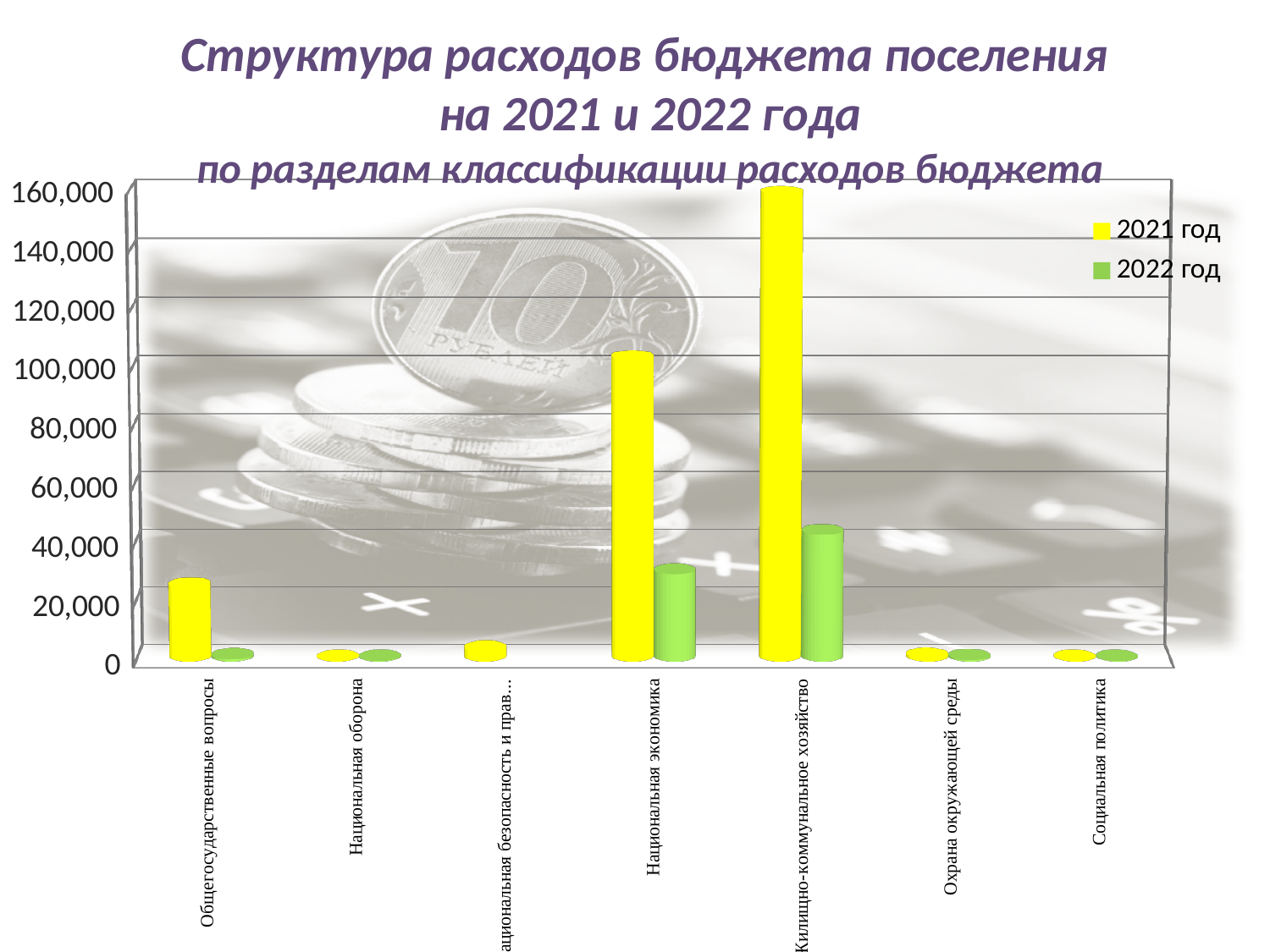
What kind of chart is shown on the slide? bar chart How many categories are shown along the x axis? 7 Which category has the highest value for the 2022 год series? Жилищно-коммунальное хозяйство Is the 2021 год value for Национальная экономика greater or less than 80,000? greater Is the 2022 год value for Жилищно-коммунальное хозяйство greater or less than 60,000? less Is the 2021 год value for Общегосударственные вопросы greater or less than 40,000? less Which colour represents the 2021 год series in the legend? yellow In the 2022 год series, which is larger: Жилищно-коммунальное хозяйство or Национальная экономика? Жилищно-коммунальное хозяйство How many series does the legend list? 2 For Национальная экономика, which series has the larger value, 2021 год or 2022 год? 2021 год Which category has the highest value for the 2021 год series? Жилищно-коммунальное хозяйство